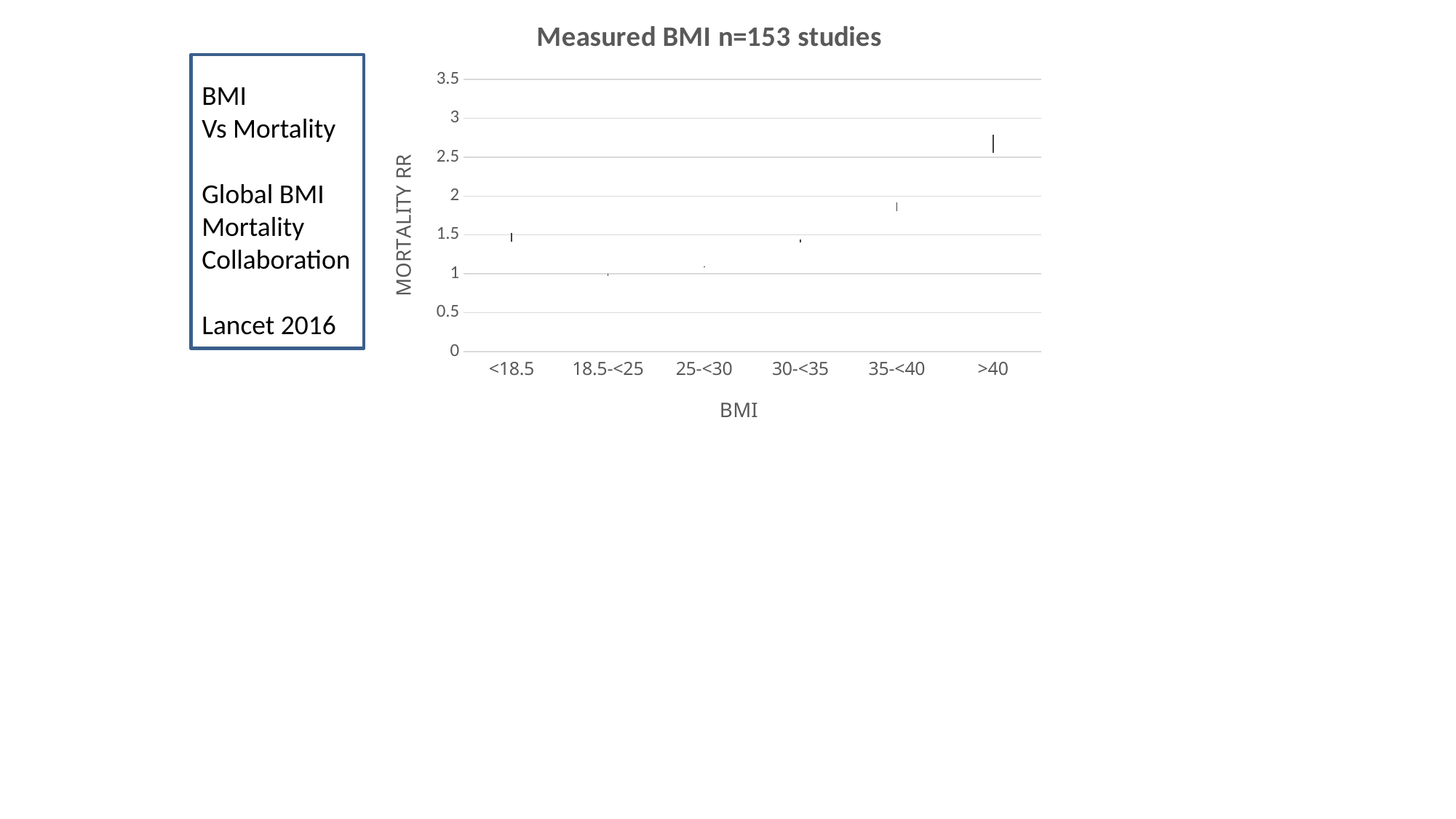
How many BMI categories are shown on the x axis? 6 Is the mortality RR for the 35-<40 BMI category greater or less than 1.5? greater Which BMI category has the highest mortality RR? >40 Which has the higher mortality RR, the <18.5 or the 18.5-<25 BMI category? <18.5 Which has the higher mortality RR, the 30-<35 or the 35-<40 BMI category? 35-<40 Which has the higher mortality RR, the >40 or the 35-<40 BMI category? >40 Is the mortality RR for the >40 BMI category greater or less than 2.5? greater What is the title of the chart? Measured BMI n=153 studies Is the mortality RR for the <18.5 BMI category greater or less than 1? greater From the 18.5-<25 category to the >40 category, does the mortality RR rise or fall? rise